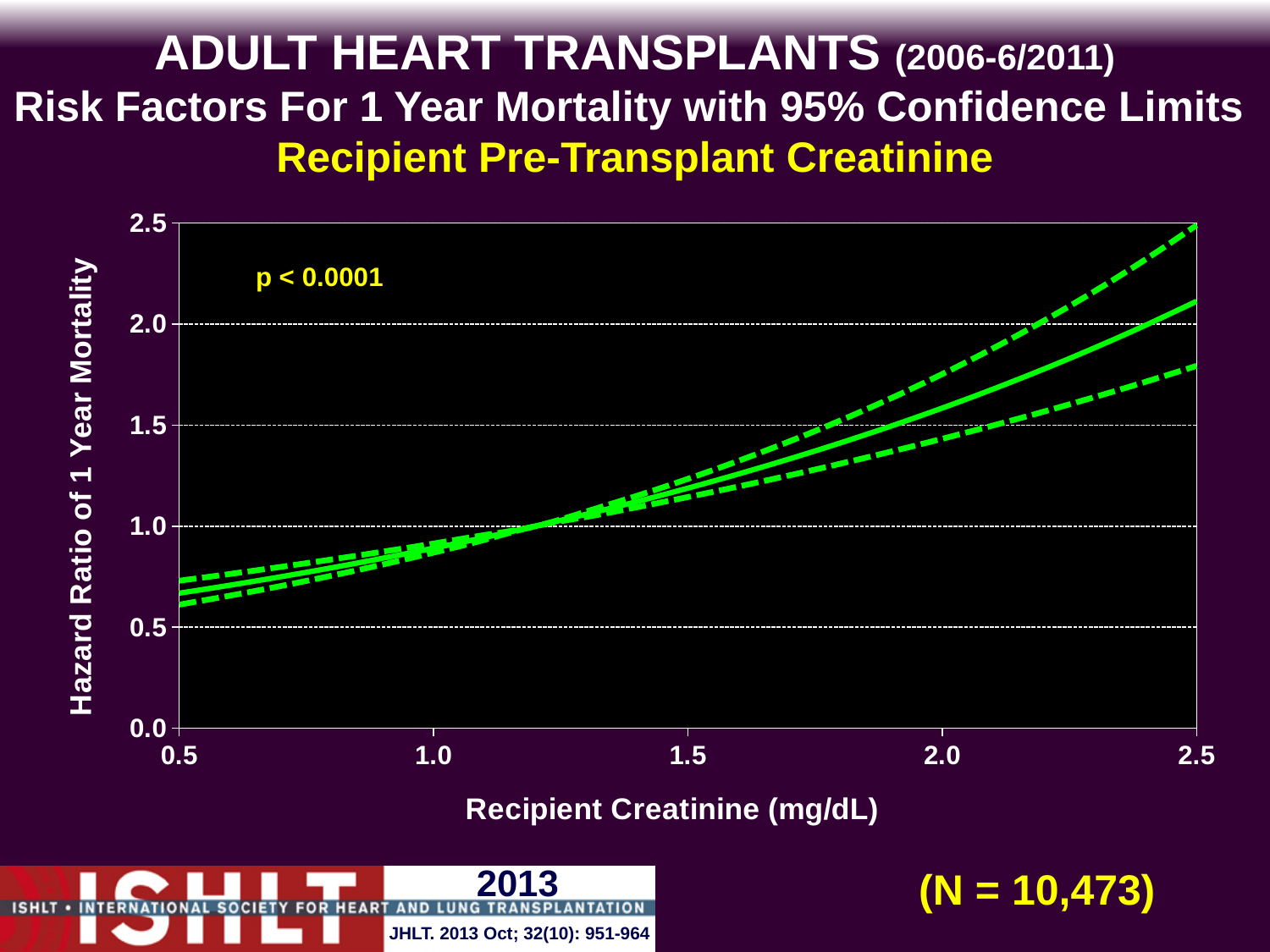
Is the hazard ratio (solid line) at a recipient creatinine of 0.5 mg/dL greater or less than 1.0? less What p-value is printed on the chart? p < 0.0001 Is the hazard ratio (solid line) at a recipient creatinine of 2.5 mg/dL greater or less than 1.5? greater What kind of chart is shown on the slide? line chart What is the label of the x axis of the chart? Recipient Creatinine (mg/dL) How many lines are plotted on the chart? 3 Is the hazard ratio (solid line) at a recipient creatinine of 1.0 mg/dL greater or less than 1.0? less How many tick labels are shown on the x axis of the chart? 5 Does the hazard ratio of 1 year mortality rise or fall as recipient creatinine increases along the x axis? rise